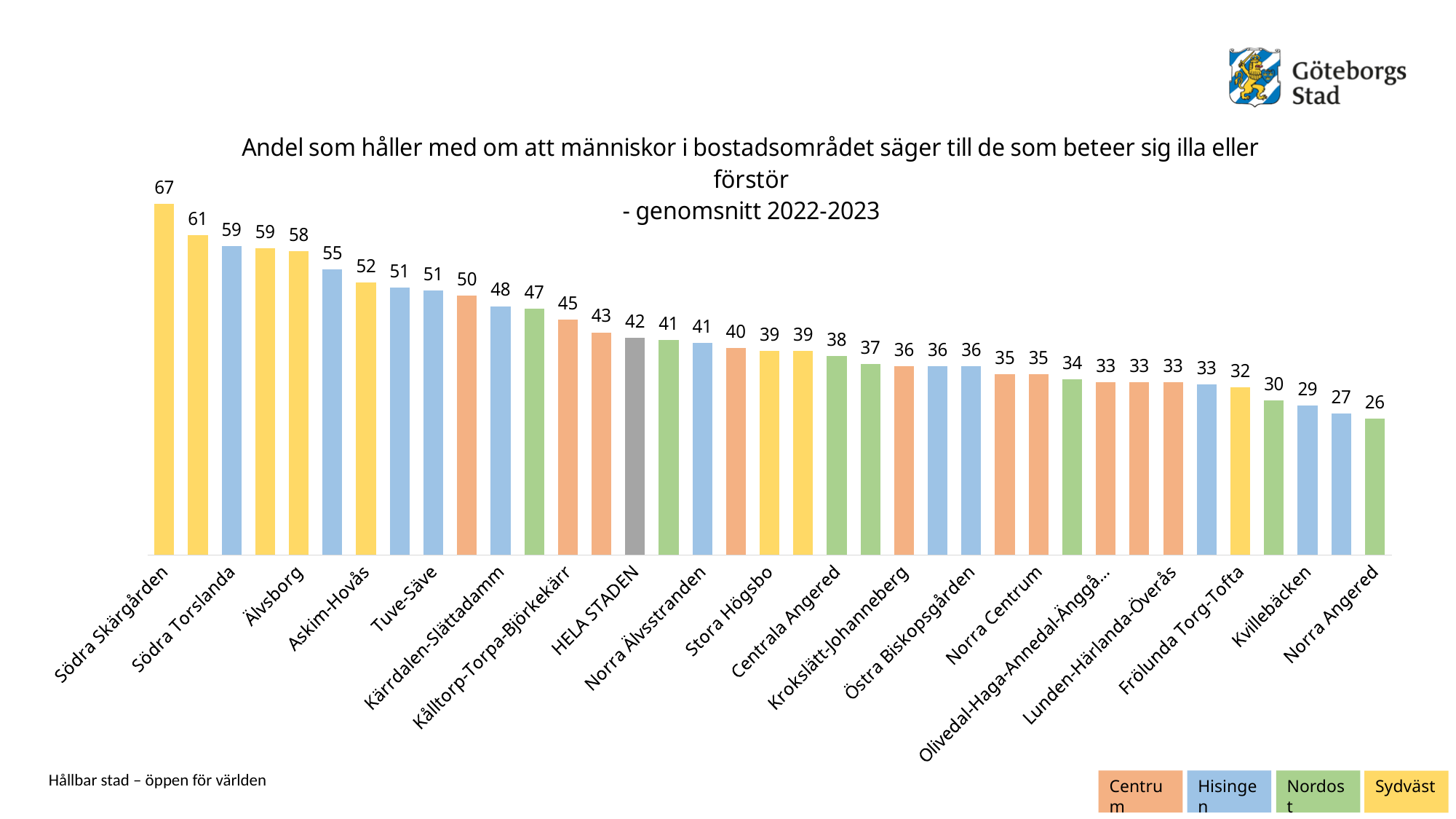
Do the values rise or fall from left to right along the x axis? fall How many entries does the legend list? 4 What is the value for HELA STADEN? 42 What kind of chart is shown on the slide? bar chart What is the difference between the value for Södra Skärgården and the value for HELA STADEN? 25 What is the value for Norra Angered? 26 Which has a larger value, Tuve-Säve or Stora Högsbo? Tuve-Säve What is the value for Kålltorp-Torpa-Björkekärr? 45 What is the value for Södra Skärgården? 67 Which labelled area has the highest value? Södra Skärgården Which labelled area has the lowest value? Norra Angered How many bars are plotted in the chart? 37